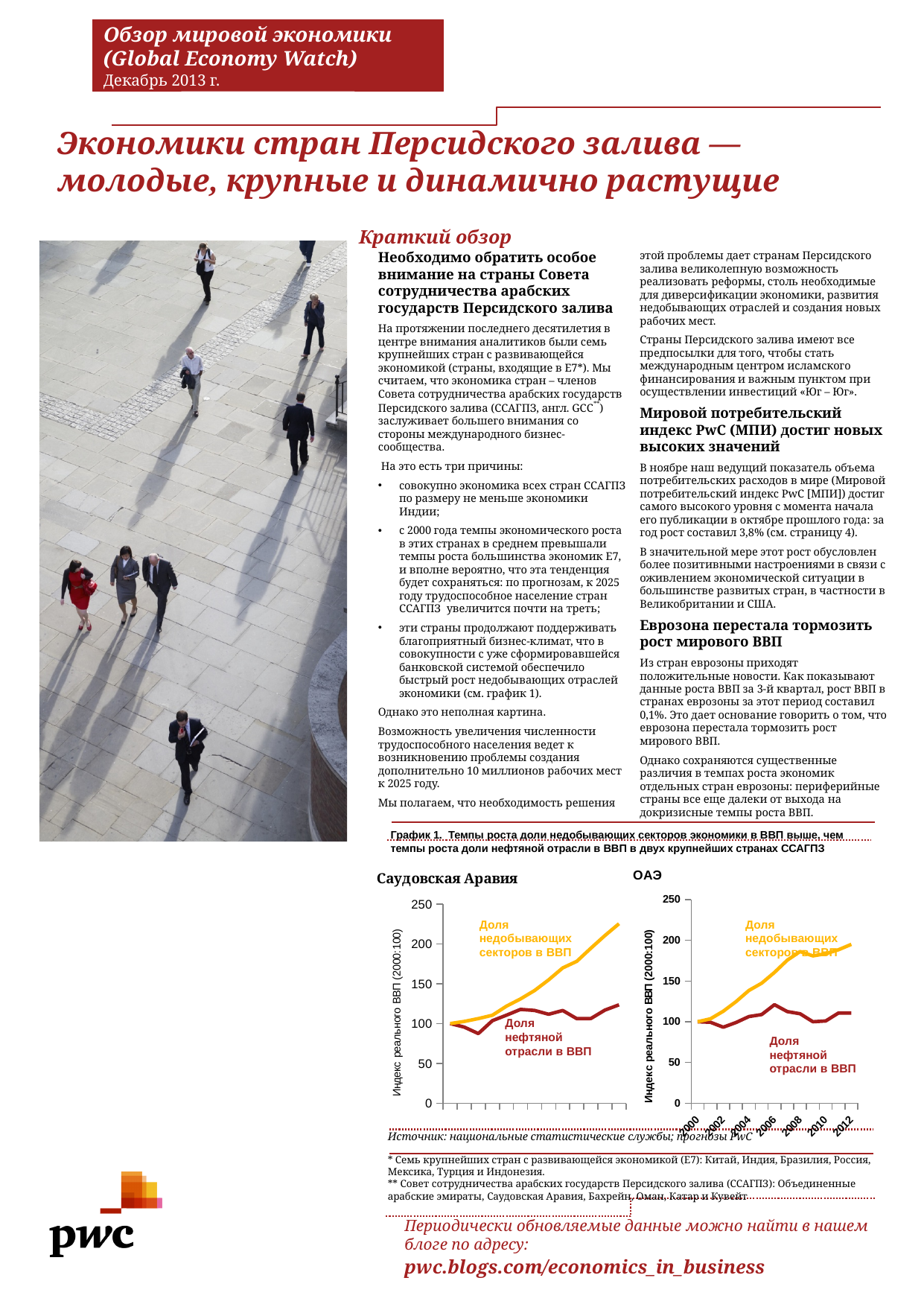
In the ОАЭ chart, which series is higher in 2012: 'Доля недобывающих секторов в ВВП' or 'Доля нефтяной отрасли в ВВП'? Доля недобывающих секторов в ВВП In the Саудовская Аравия chart, what is the value of both series in 2000? 100 What is the y-axis label of the ОАЭ chart? Индекс реального ВВП (2000:100) How many series are plotted in the ОАЭ chart? 2 In the ОАЭ chart, is the 2012 value of 'Доля недобывающих секторов в ВВП' greater or less than 150? greater In the Саудовская Аравия chart, is the 2012 value of 'Доля нефтяной отрасли в ВВП' greater or less than 150? less In the Саудовская Аравия chart, is the 2012 value of 'Доля недобывающих секторов в ВВП' greater or less than 200? greater How many separate charts are shown under График 1? 2 In the ОАЭ chart, what is the value of the 'Доля нефтяной отрасли в ВВП' series in 2000? 100 In the Саудовская Аравия chart, does the 'Доля недобывающих секторов в ВВП' series rise or fall from 2000 to 2012? rise What kind of chart is used for the Saudi Arabia (Саудовская Аравия) panel of График 1? line chart